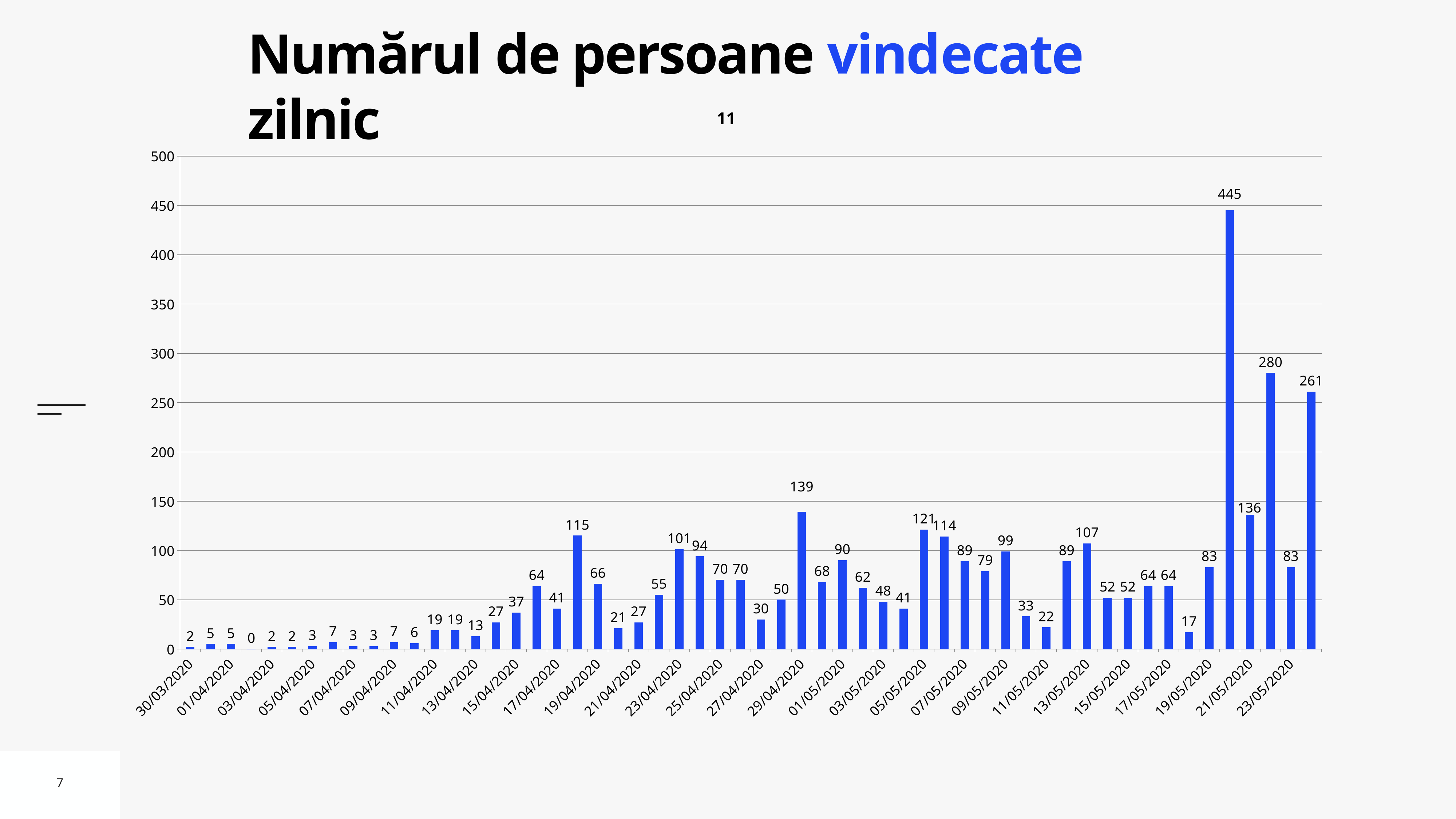
What is the value for 21/05/2020? 136 Which is larger, the value for 29/04/2020 or the value for 05/05/2020? 29/04/2020 What is the value for 29/04/2020? 139 Is the value for 21/05/2020 greater or less than 100? greater What is the highest value shown on the chart? 445 What is the title of the slide? Numărul de persoane vindecate zilnic What is the value for 23/04/2020? 101 What kind of chart is shown on the slide? bar chart What is the value for 05/05/2020? 121 What is the lowest value shown on the chart? 0 What is the difference between the two tallest bars, 445 and 280? 165 Do the values generally rise or fall from left to right along the x axis? rise